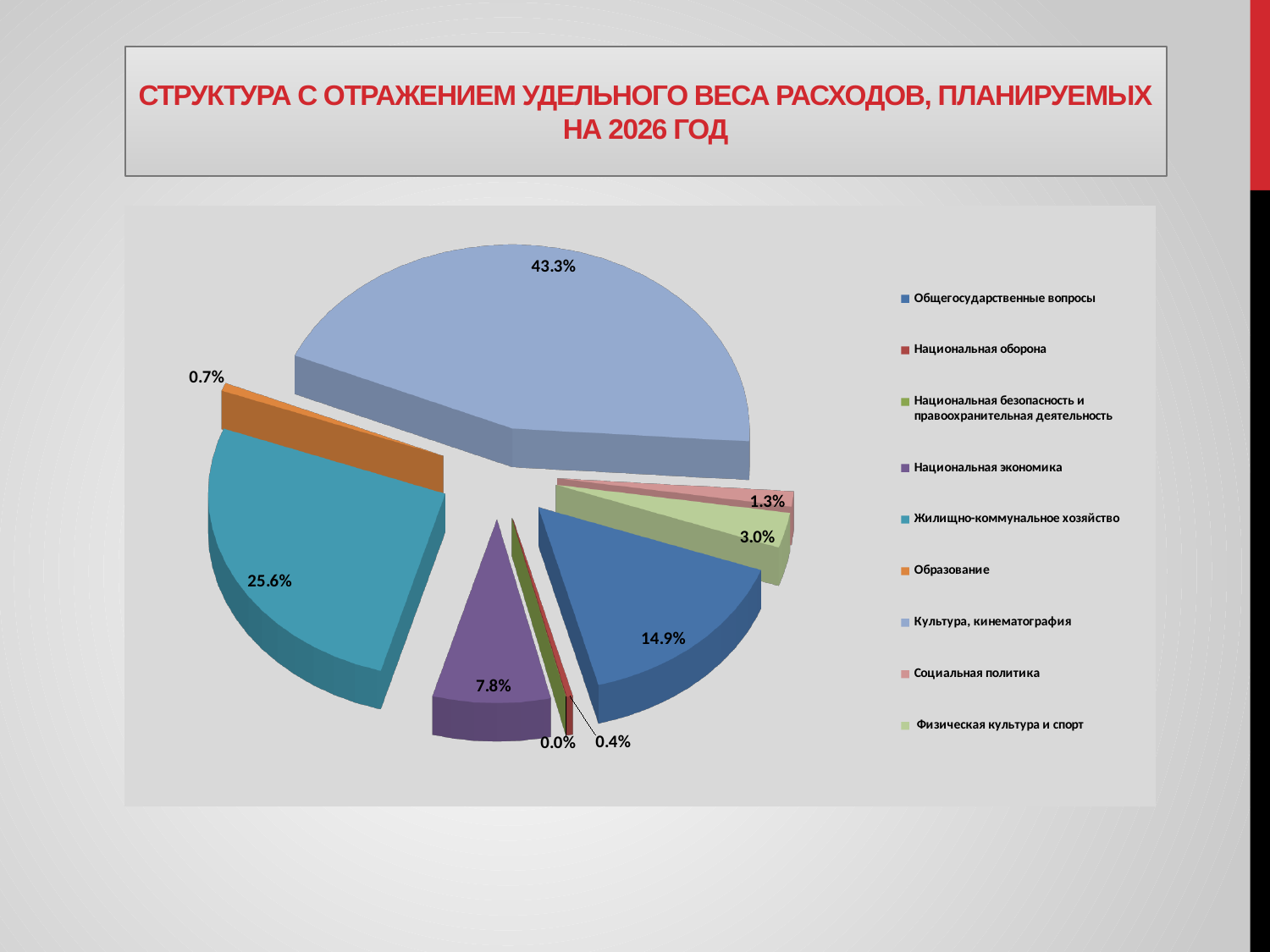
What share of planned 2026 expenditures goes to Общегосударственные вопросы? 14.9% What kind of chart is shown on the slide? Pie chart Which category has the largest share of planned 2026 expenditures? Культура, кинематография What share of planned 2026 expenditures goes to Культура, кинематография? 43.3% Which has a larger share: Физическая культура и спорт or Социальная политика? Физическая культура и спорт What share of planned 2026 expenditures goes to Социальная политика? 1.3% What share of planned 2026 expenditures goes to Образование? 0.7% What share of planned 2026 expenditures goes to Жилищно-коммунальное хозяйство? 25.6% What is the difference in percentage points between the shares for Культура, кинематография and Жилищно-коммунальное хозяйство? 17.7 How many categories does the legend list? 9 Which category has the smallest share of planned 2026 expenditures? Национальная безопасность и правоохранительная деятельность What share of planned 2026 expenditures goes to Национальная экономика? 7.8%